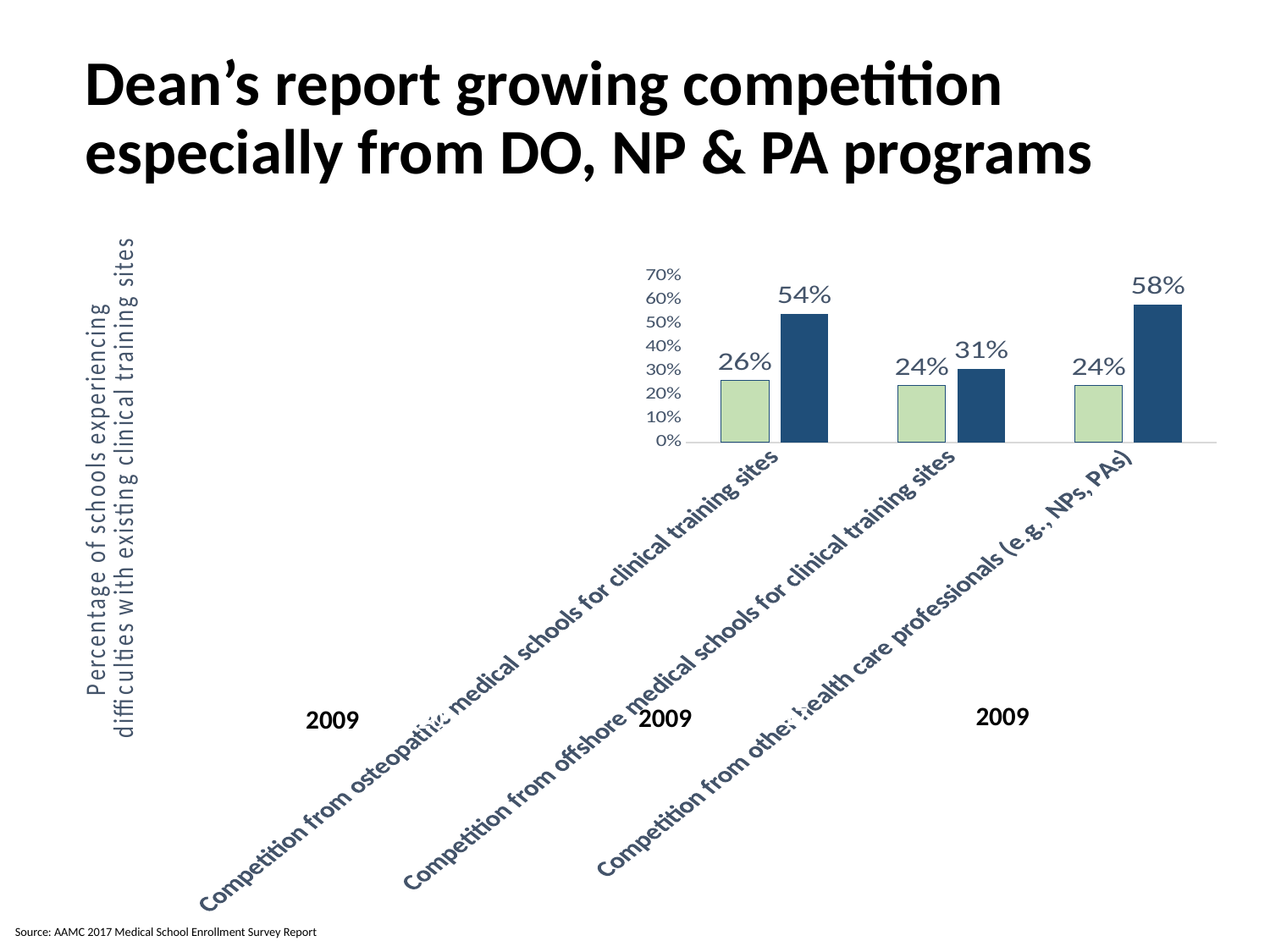
Which category has the lowest dark blue bar? Competition from offshore medical schools for clinical training sites What is the value of the dark blue bar for 'Competition from osteopathic medical schools for clinical training sites'? 54% What is the difference between the dark blue and light green bars for 'Competition from osteopathic medical schools for clinical training sites'? 28 percentage points Which has a larger dark blue bar: 'Competition from osteopathic medical schools' or 'Competition from offshore medical schools'? Competition from osteopathic medical schools What kind of chart is shown on the slide? Bar chart Which category has the highest dark blue bar? Competition from other health care professionals (e.g., NPs, PAs) How many categories are shown on the x axis of the chart? 3 What is the label on the vertical axis of the chart? Percentage of schools experiencing difficulties with existing clinical training sites What is the value of the light green bar for 'Competition from osteopathic medical schools for clinical training sites'? 26% What is the value of the dark blue bar for 'Competition from other health care professionals (e.g., NPs, PAs)'? 58% What is the value of the light green bar for 'Competition from offshore medical schools for clinical training sites'? 24% What is the difference between the dark blue and light green bars for 'Competition from other health care professionals (e.g., NPs, PAs)'? 34 percentage points